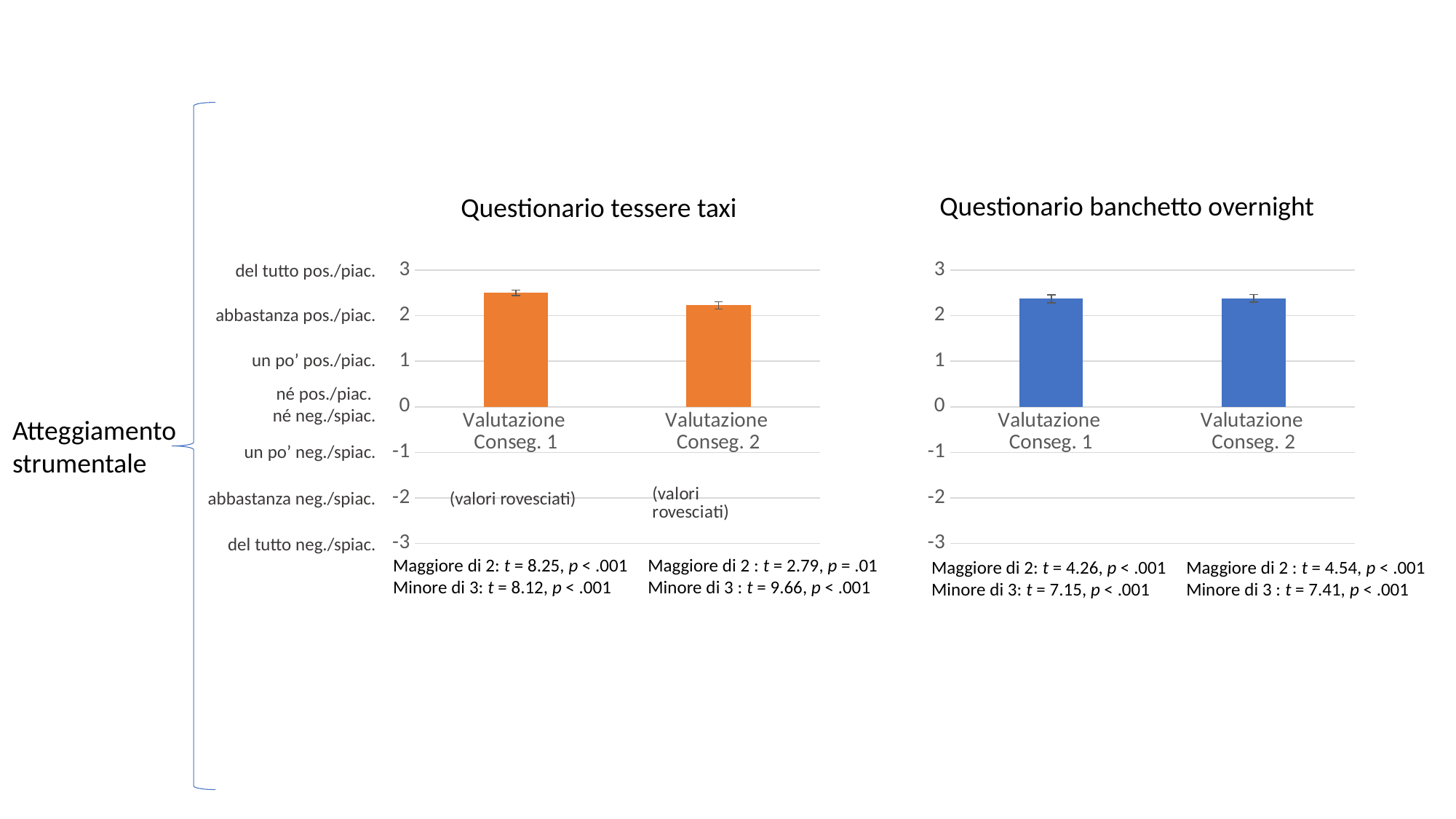
What kind of chart is the 'Questionario banchetto overnight' chart? bar chart In the 'Questionario banchetto overnight' chart, is the value for Valutazione Conseg. 1 greater or less than 2? greater What kind of chart is the 'Questionario tessere taxi' chart? bar chart How many bars are plotted in the 'Questionario banchetto overnight' chart? 2 In the 'Questionario tessere taxi' chart, which bar is higher: Valutazione Conseg. 1 or Valutazione Conseg. 2? Valutazione Conseg. 1 In the 'Questionario banchetto overnight' chart, is the value for Valutazione Conseg. 2 greater or less than 3? less In the 'Questionario tessere taxi' chart, is the value for Valutazione Conseg. 1 greater or less than 2? greater What colour are the bars in the 'Questionario banchetto overnight' chart? blue How many bars are plotted in the 'Questionario tessere taxi' chart? 2 In the 'Questionario tessere taxi' chart, which category has the lowest value? Valutazione Conseg. 2 What is the title of the chart on the left of the slide? Questionario tessere taxi